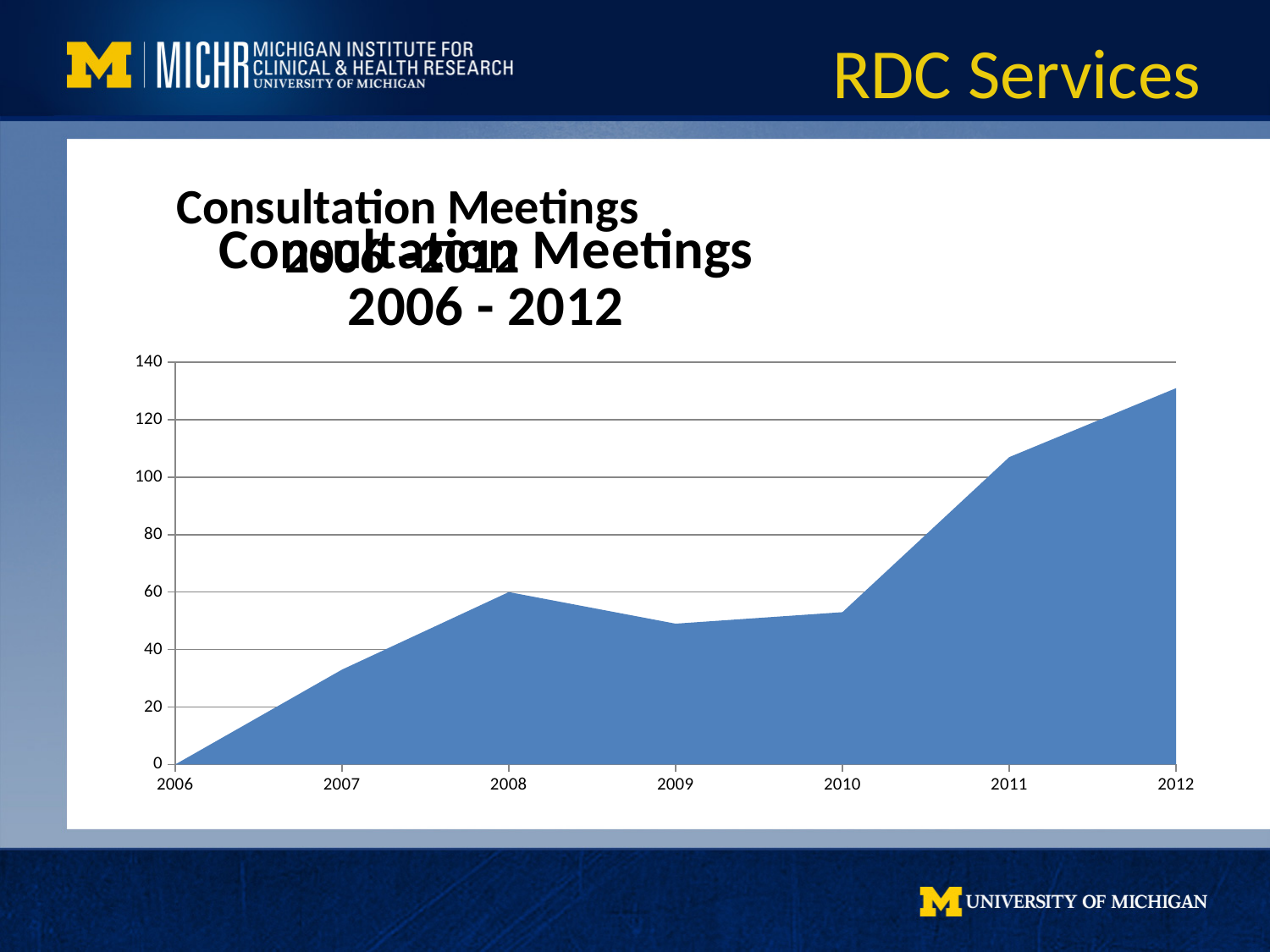
Which year has the lowest number of consultation meetings? 2006 How many years are plotted along the x axis of the chart? 7 Is the value for 2009 greater or less than 60? less What is the title of the chart? Consultation Meetings 2006 - 2012 What is the value for 2006? 0 Is the value for 2012 greater or less than 120? greater Do the values rise or fall from 2008 to 2009? fall Which year has the highest number of consultation meetings? 2012 Is the value for 2011 greater or less than 100? greater Which year has a higher value, 2008 or 2009? 2008 What kind of chart is shown on the slide? area chart